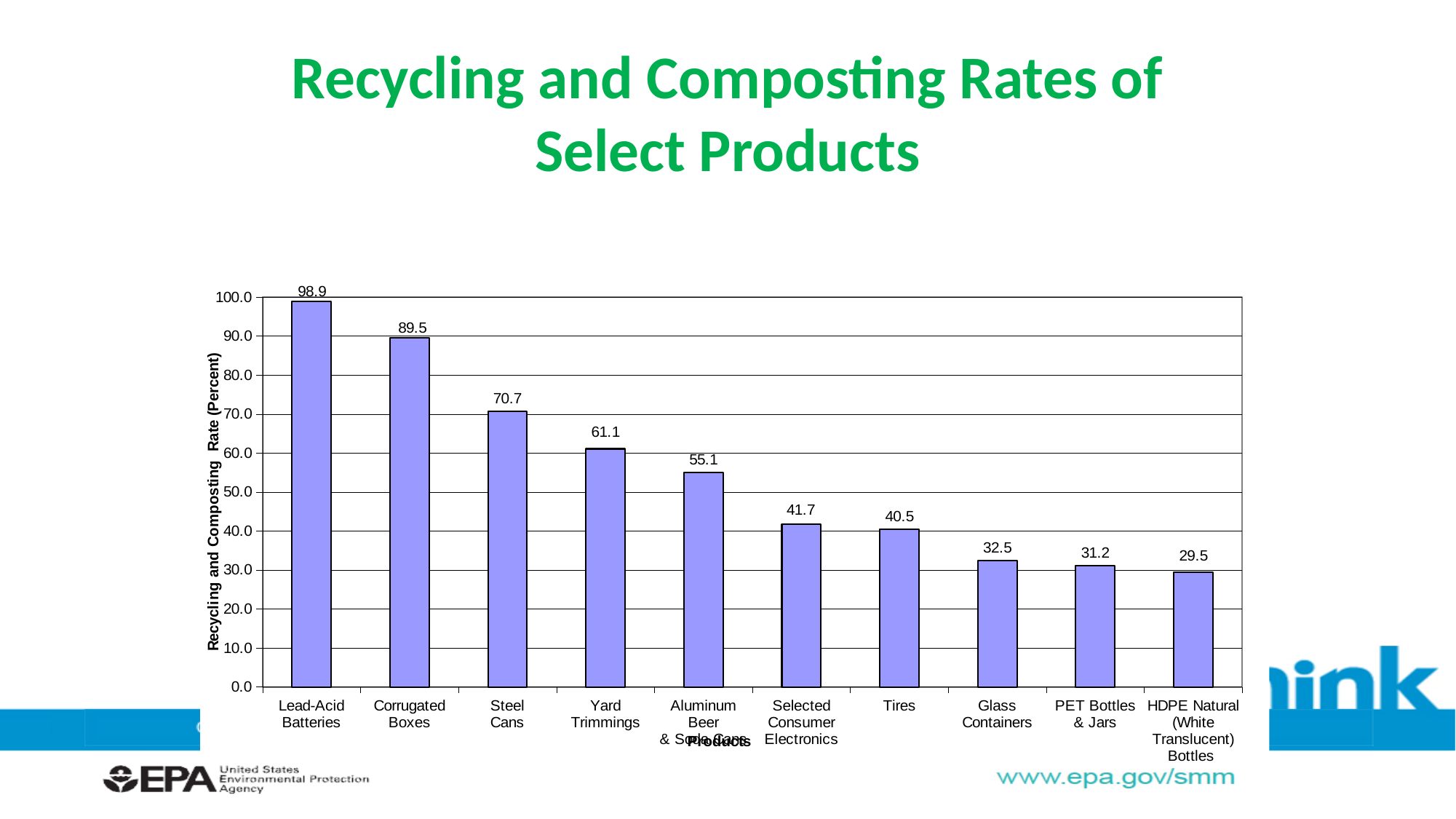
What is the recycling and composting rate for Steel Cans? 70.7 What is the recycling and composting rate for Glass Containers? 32.5 Is the value for PET Bottles & Jars greater or less than 40.0? less Do the values rise or fall from left to right across the chart? Fall What is the recycling and composting rate for Lead-Acid Batteries? 98.9 Which product has the lowest recycling and composting rate? HDPE Natural (White Translucent) Bottles How many products are shown in the chart? 10 What is the difference between the rates for Corrugated Boxes and Yard Trimmings? 28.4 Which product has the highest recycling and composting rate? Lead-Acid Batteries What is the recycling and composting rate for Tires? 40.5 What kind of chart is shown on the slide? Bar chart Which has a higher recycling and composting rate, Aluminum Beer & Soda Cans or Selected Consumer Electronics? Aluminum Beer & Soda Cans